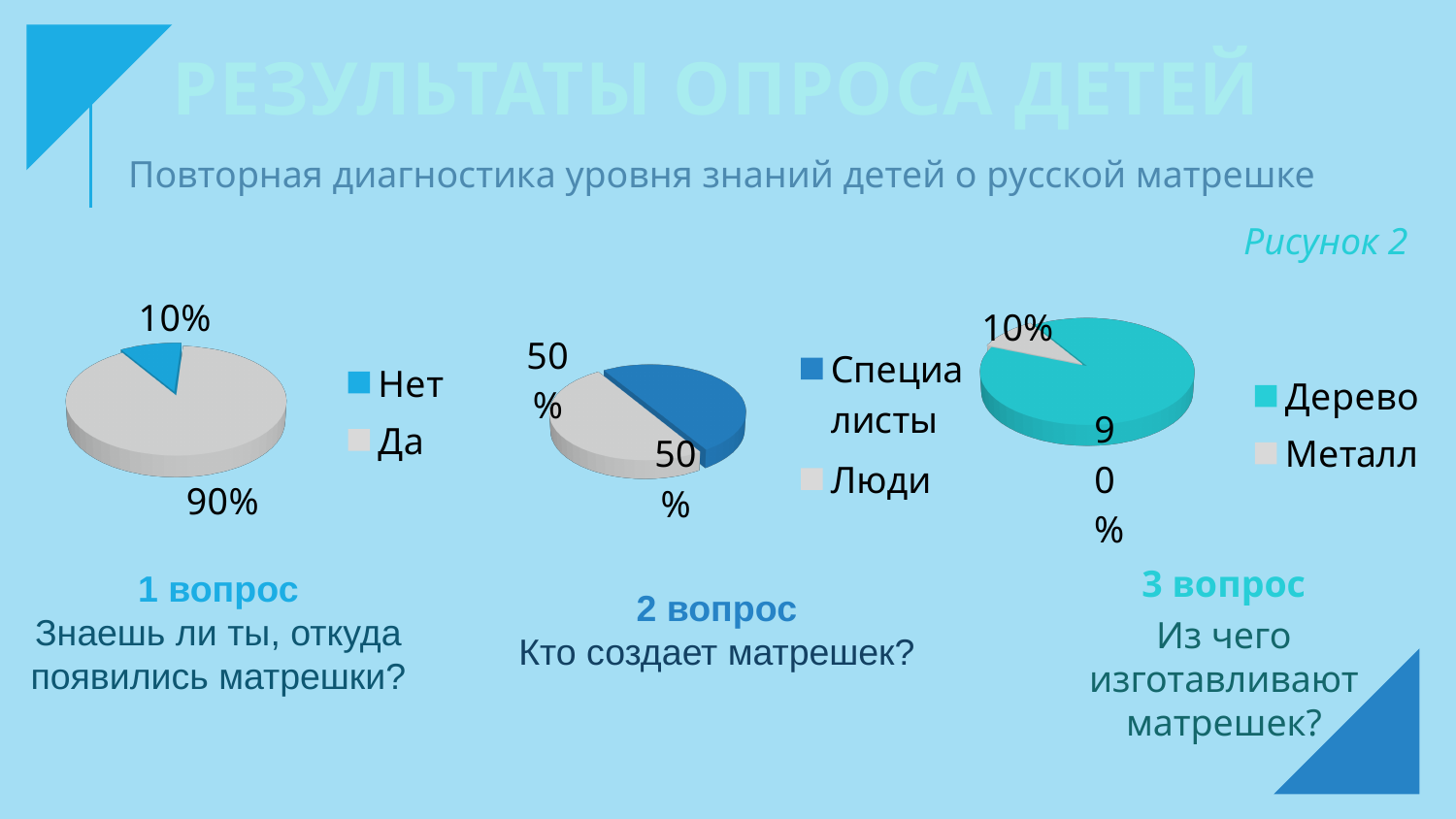
How many pie charts are shown on the slide? 3 In the left pie chart (1 вопрос), which answer has the largest share? Да In the right pie chart (3 вопрос), which answer has the smallest share? Металл In the left pie chart (1 вопрос), what share of children answered "Да"? 90% In the left pie chart (1 вопрос), what share of children answered "Нет"? 10% In the middle pie chart (2 вопрос), what share is labelled "Специалисты"? 50% What type of chart is used for the three charts on the slide? Pie chart In the right pie chart (3 вопрос), which is larger: the share for "Дерево" or for "Металл"? Дерево How many categories does the legend of the middle pie chart (2 вопрос) list? 2 In the left pie chart (1 вопрос), what is the difference between the shares for "Да" and "Нет"? 80% In the right pie chart (3 вопрос), what share of children answered "Металл"? 10% In the right pie chart (3 вопрос), what share of children answered "Дерево"? 90%